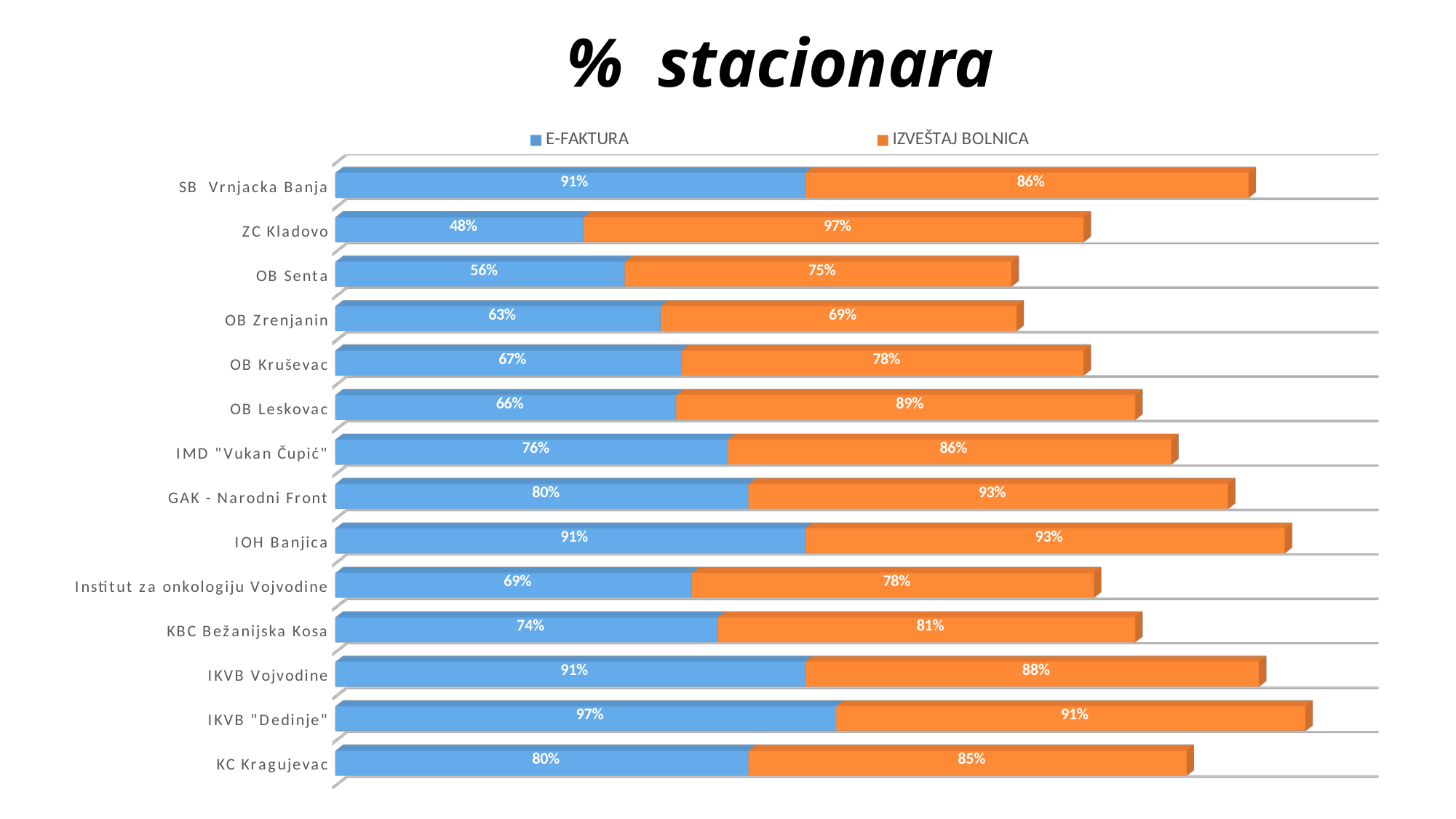
Which category has the highest E-FAKTURA value? IKVB "Dedinje" Which is larger for IKVB Vojvodine, the E-FAKTURA value or the IZVEŠTAJ BOLNICA value? E-FAKTURA How many series does the legend list? 2 What is the title of the chart? % stacionara What is the E-FAKTURA value for IMD "Vukan Čupić"? 76% What is the IZVEŠTAJ BOLNICA value for OB Leskovac? 89% What is the difference between the IZVEŠTAJ BOLNICA and E-FAKTURA values for ZC Kladovo? 49% What kind of chart is shown on the slide? Stacked bar chart Which category has the lowest E-FAKTURA value? ZC Kladovo What is the E-FAKTURA value for ZC Kladovo? 48% How many categories (institutions) are shown in the chart? 14 Which category has the lowest IZVEŠTAJ BOLNICA value? OB Zrenjanin